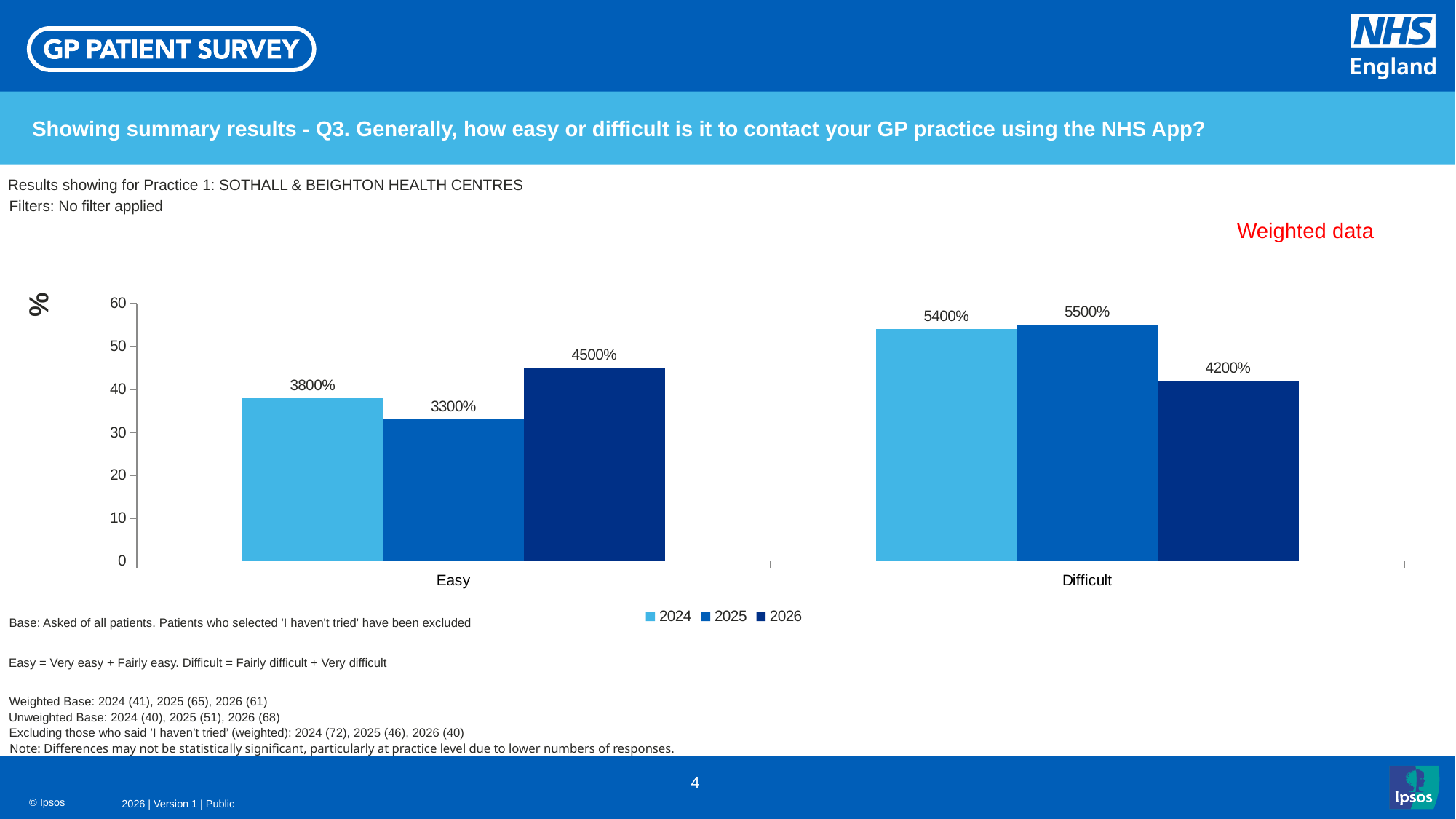
What is the data label for 2025 in the Easy category? 3300% Which year has the highest bar in the Difficult category? 2025 Which is larger: the 2026 bar for Easy or the 2026 bar for Difficult? Easy What is the data label for 2026 in the Difficult category? 4200% Is the 2024 bar for Difficult greater or less than 50 on the y axis? greater Which year has the lowest bar in the Easy category? 2025 Is the 2025 bar for Easy greater or less than 40 on the y axis? less Which years are listed in the chart legend? 2024, 2025, 2026 What is the data label for 2024 in the Easy category? 3800% How many series does the legend list? 3 What type of chart is shown on the slide? Bar chart How many categories are shown on the x axis? 2